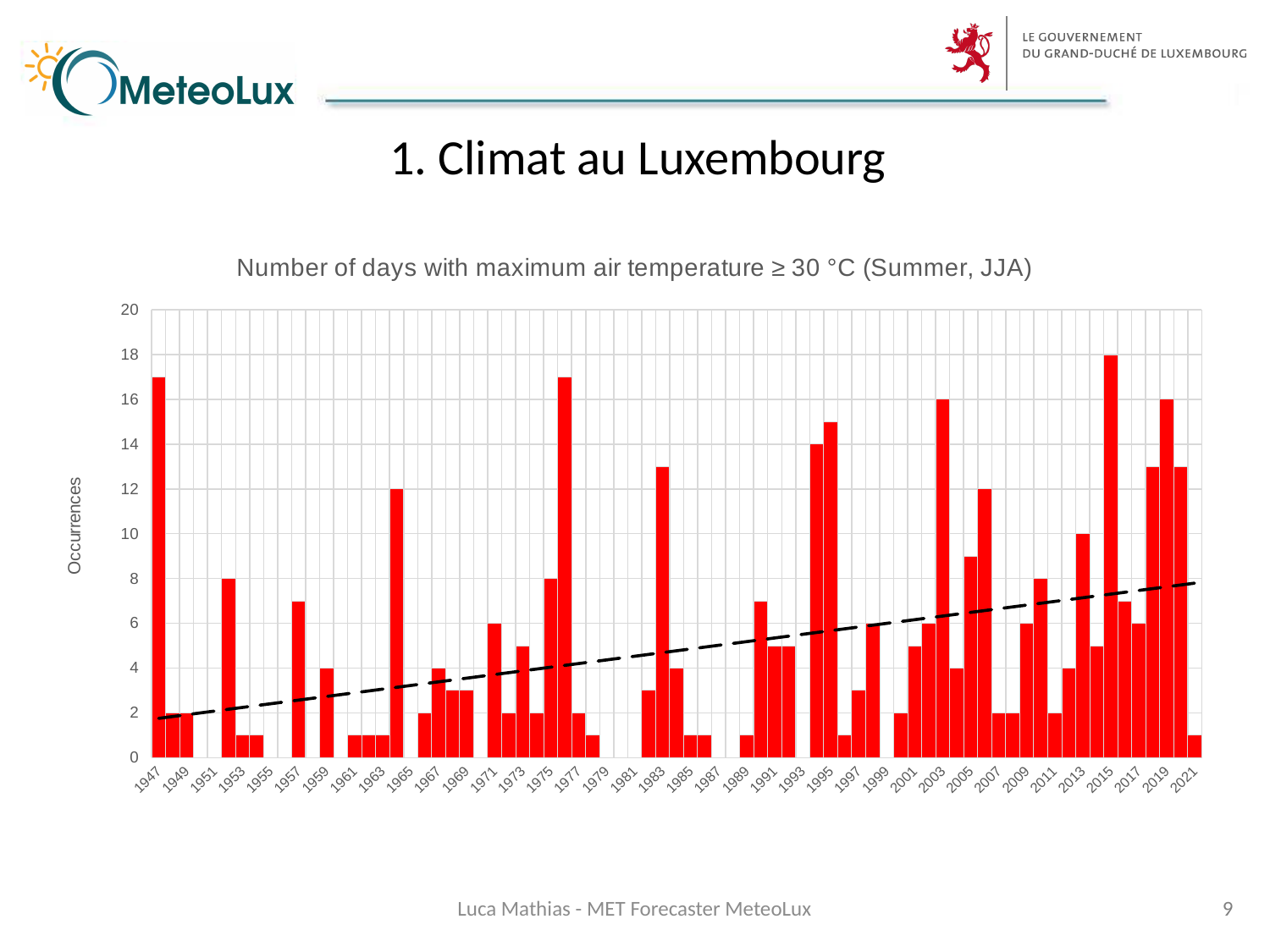
Is the value for 1947 greater or less than 16? greater What kind of chart is shown on the slide? bar chart What is the value for 2015? 18 What is the value for 2013? 10 What is the value for 1975? 8 Which year has the highest number of occurrences? 2015 What is the label of the vertical axis? Occurrences What is the value for 2003? 16 Which is larger, the value for 2003 or the value for 2013? 2003 What is the title of the chart? Number of days with maximum air temperature ≥ 30 °C (Summer, JJA) According to the dashed trend line, do the values rise or fall over the years? rise Is the value for 1983 greater or less than 12? greater